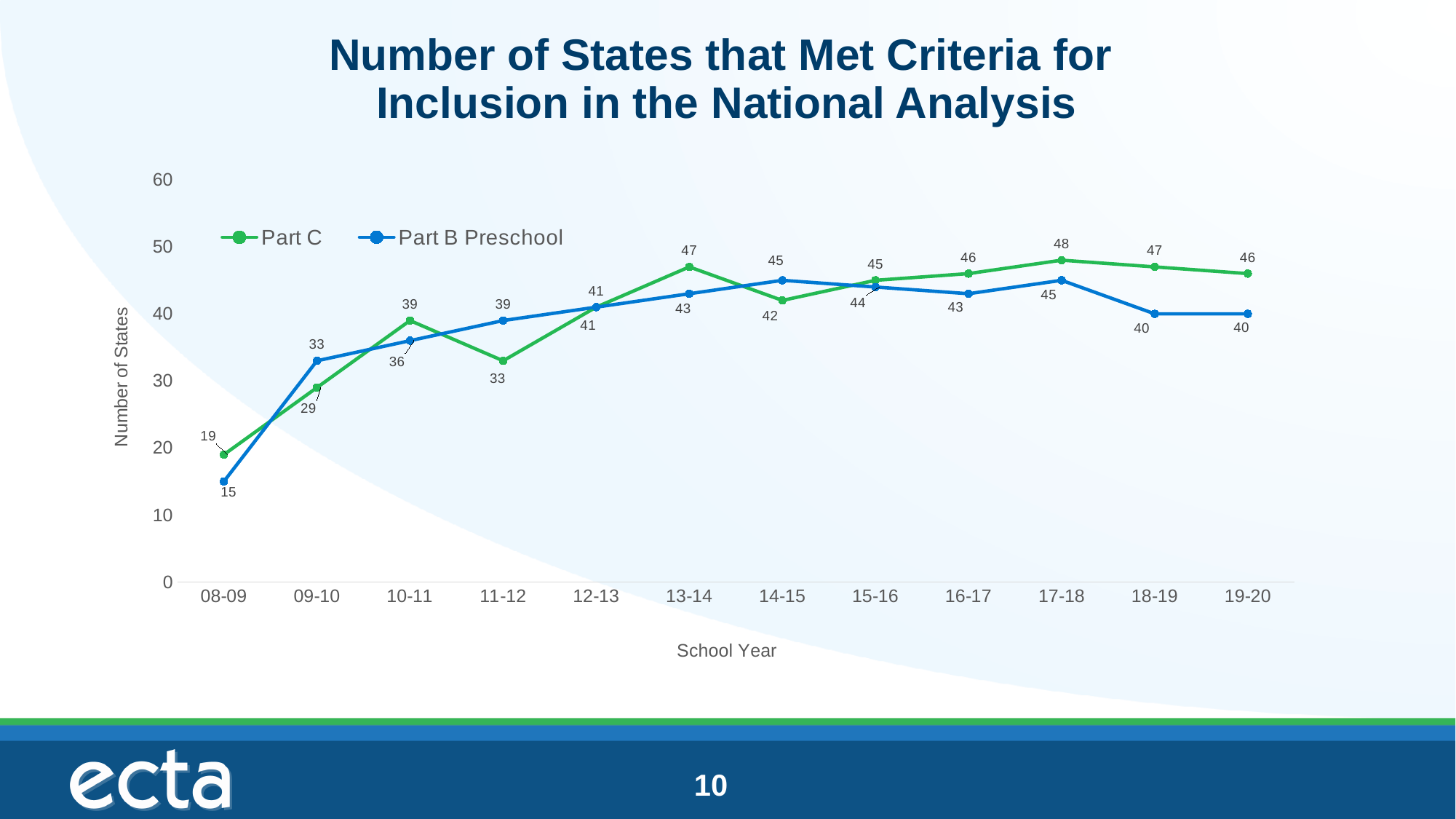
In which school year does Part C reach its highest value? 17-18 How many series does the legend list? 2 What is the label of the y axis? Number of States Does the Part B Preschool value rise or fall from school year 08-09 to 09-10? Rise Which series has the larger value in school year 14-15, Part C or Part B Preschool? Part B Preschool What kind of chart is shown on the slide? Line chart What is the Part C value for school year 11-12? 33 How many school years are shown on the x axis? 12 What is the Part C value for school year 13-14? 47 In which school year is the Part B Preschool value lowest? 08-09 What is the Part B Preschool value for school year 08-09? 15 What is the difference between the Part C and Part B Preschool values in school year 18-19? 7